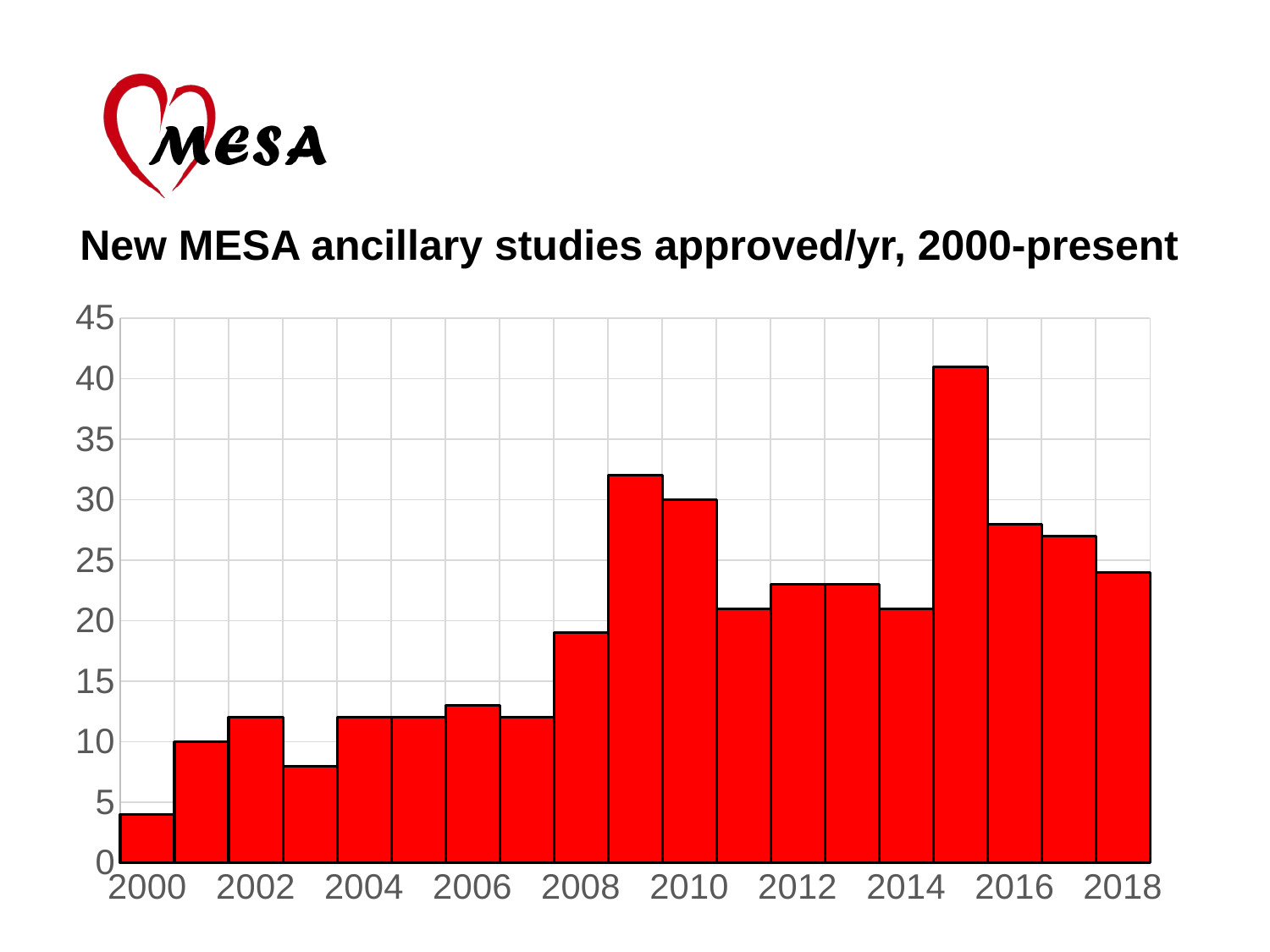
Which year has the lowest number of new ancillary studies approved? 2000 Is the value for 2015 greater or less than 35? greater Is the value for 2000 greater or less than 10? less How many years (bars) are plotted in the chart? 19 Which year has a larger value, 2016 or 2018? 2016 Do the values rise or fall from 2015 to 2018? fall What kind of chart is shown on the slide? bar chart Which year has a larger value, 2009 or 2015? 2015 Is the value for 2016 greater or less than 25? greater Which year has the highest number of new ancillary studies approved? 2015 What is the title of the chart? New MESA ancillary studies approved/yr, 2000-present